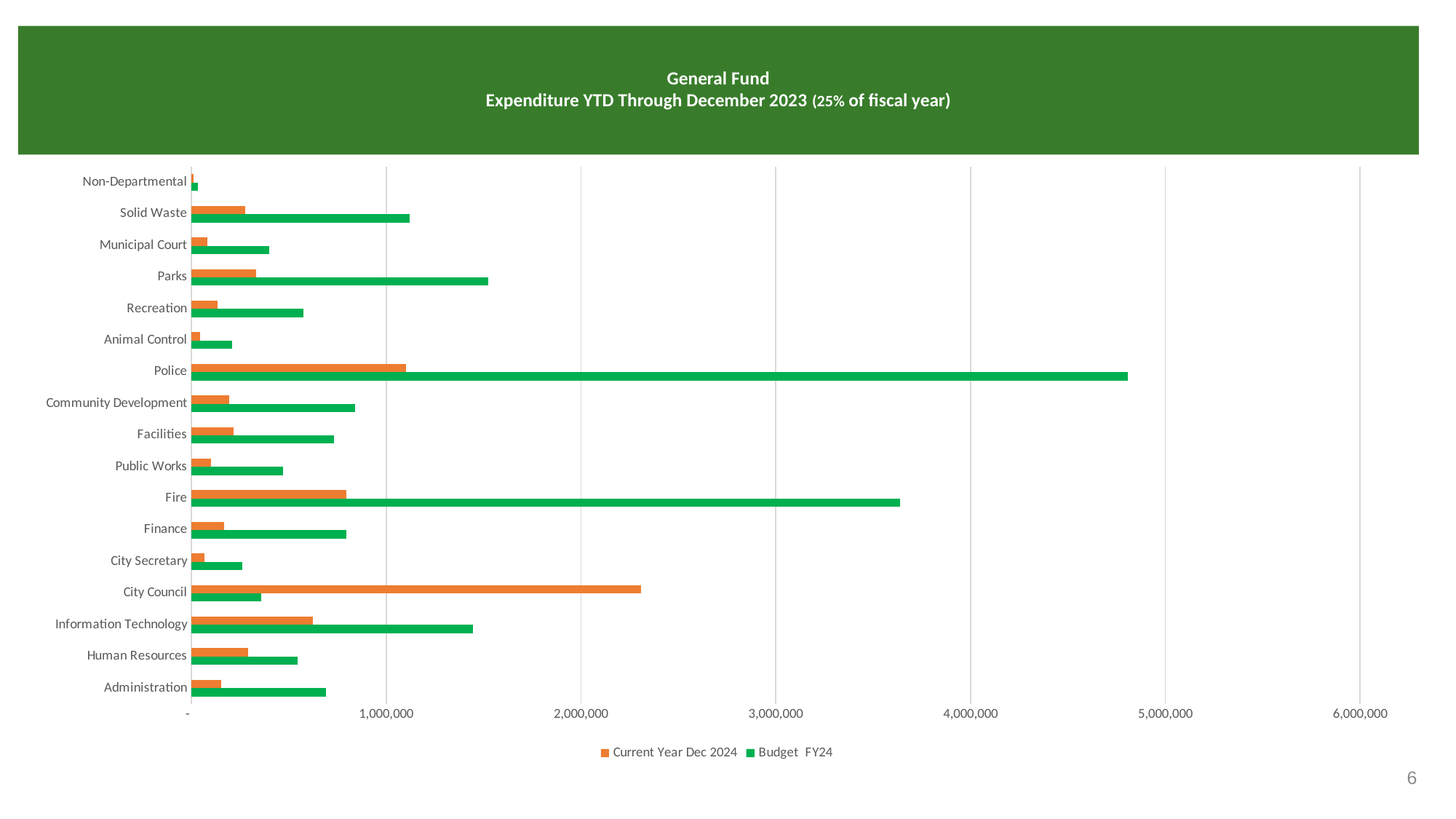
Which series is shown in orange in the legend? Current Year Dec 2024 Which department has the lowest Budget FY24 value? Non-Departmental Which department has the highest Budget FY24 value? Police Is the Budget FY24 value for Fire greater or less than 3,000,000? greater Which is larger: the Budget FY24 value for Police or the Budget FY24 value for Fire? Police How many series does the legend list? 2 Is the Current Year Dec 2024 value for City Council greater or less than 2,000,000? greater Which department has the highest Current Year Dec 2024 value? City Council How many departments (categories) are plotted on the chart? 17 What kind of chart is shown on the slide? Bar chart Is the Budget FY24 value for Information Technology greater or less than 1,000,000? greater